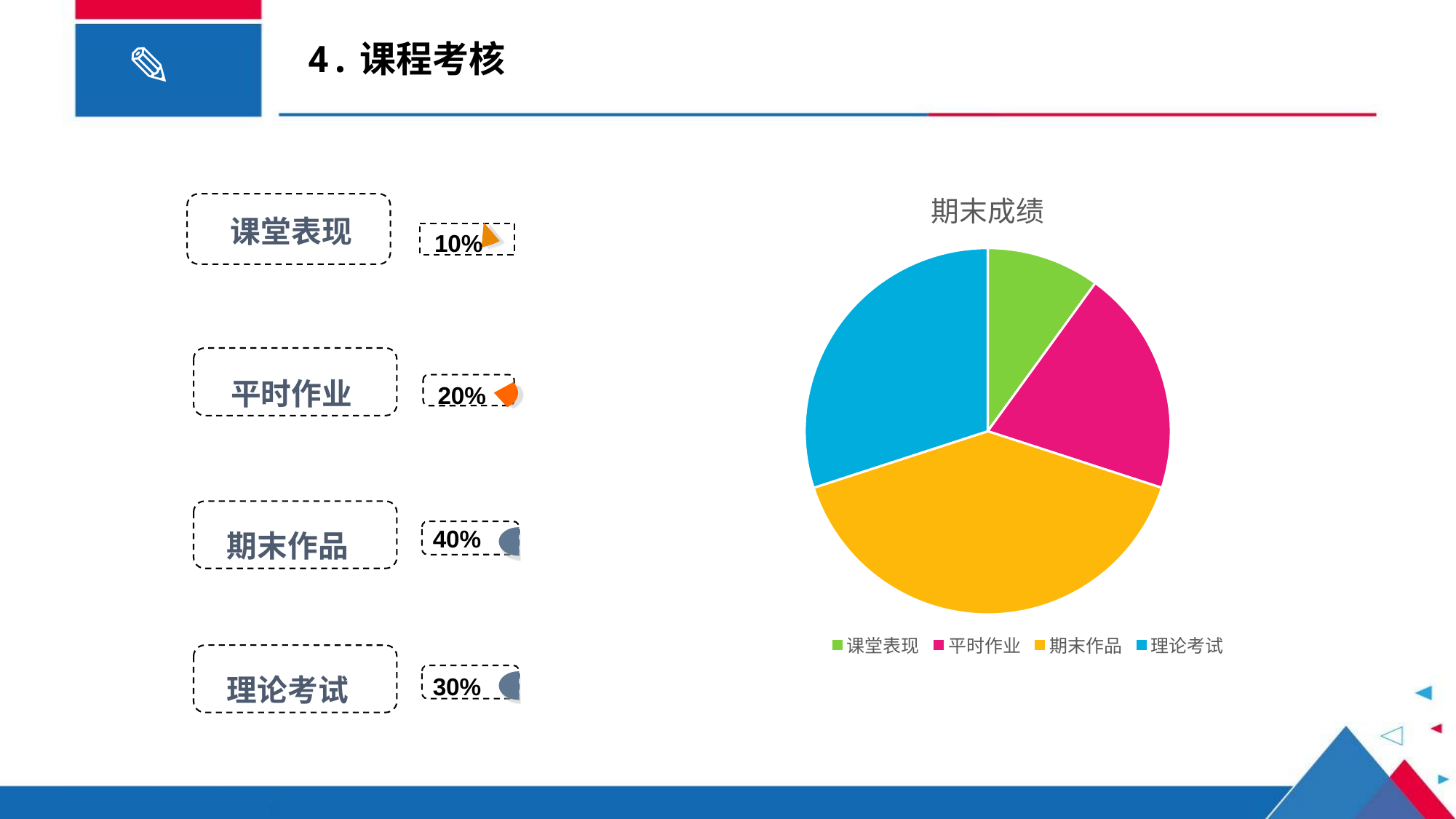
What is the value for 课堂表现? 10% What is the title of the pie chart? 期末成绩 What share of the pie does 理论考试 account for? 30% What is the value for 平时作业? 20% Which is larger, the slice for 理论考试 or the slice for 平时作业? 理论考试 What kind of chart is shown on the slide? pie chart What is the difference between the share for 期末作品 and the share for 课堂表现? 30% How many slices does the pie chart have? 4 Which category has the largest slice in the pie chart? 期末作品 How many entries does the legend of the pie chart list? 4 What share of the pie does 期末作品 account for? 40% Which category has the smallest slice in the pie chart? 课堂表现